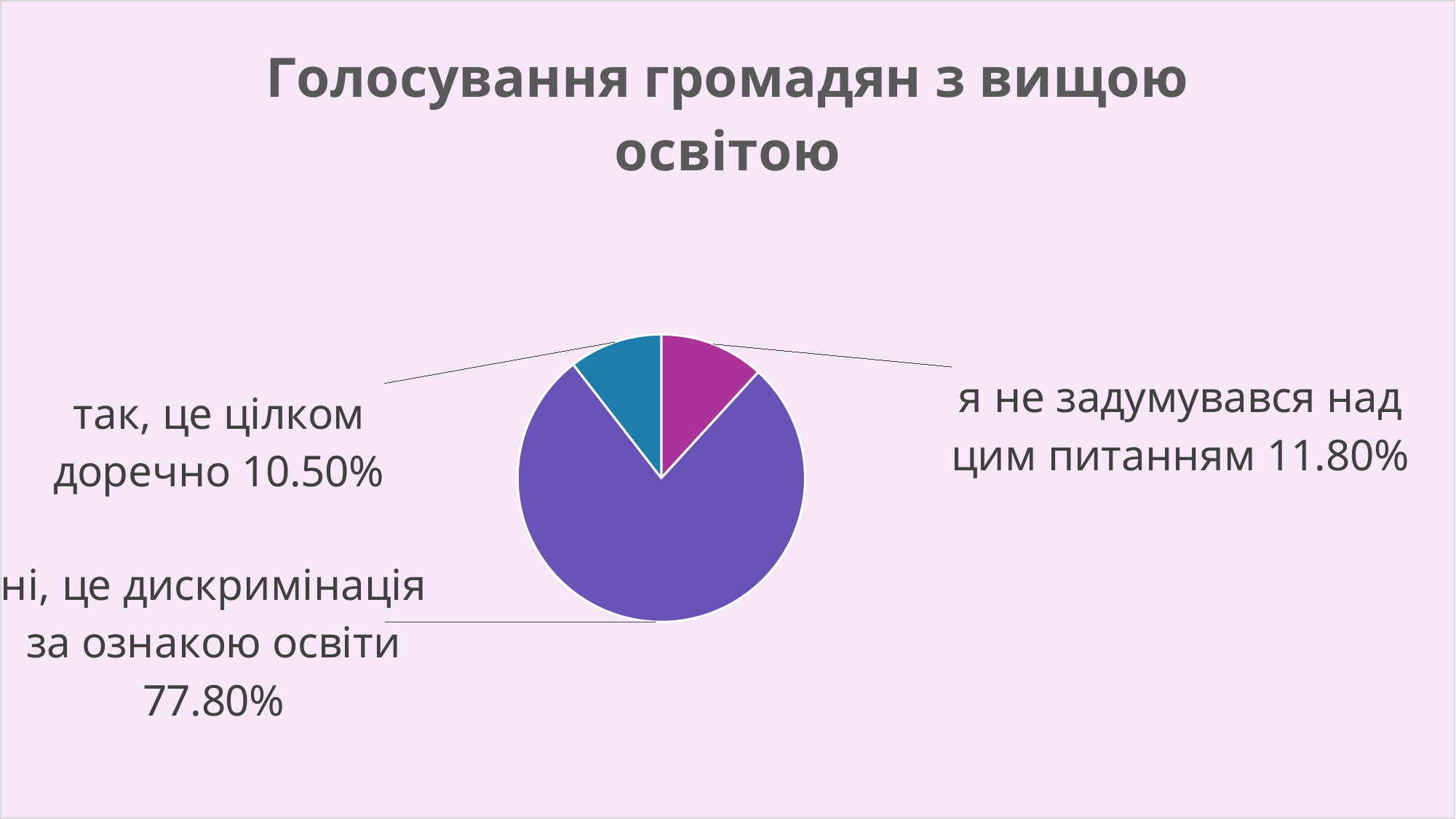
What is the difference between the share for "ні, це дискримінація за ознакою освіти" and the share for "я не задумувався над цим питанням"? 66.00% What colour is the slice for "ні, це дискримінація за ознакою освіти"? purple What share of the pie is labelled "ні, це дискримінація за ознакою освіти"? 77.80% How many slices does the pie chart have? 3 Which slice of the pie is the smallest? так, це цілком доречно Which is larger: the share for "я не задумувався над цим питанням" or the share for "так, це цілком доречно"? я не задумувався над цим питанням What is the difference between the share for "я не задумувався над цим питанням" and the share for "так, це цілком доречно"? 1.30% What share of the pie is labelled "я не задумувався над цим питанням"? 11.80% What kind of chart is shown on the slide? pie chart Which slice of the pie is the largest? ні, це дискримінація за ознакою освіти What share of the pie is labelled "так, це цілком доречно"? 10.50% What is the title of the chart? Голосування громадян з вищою освітою